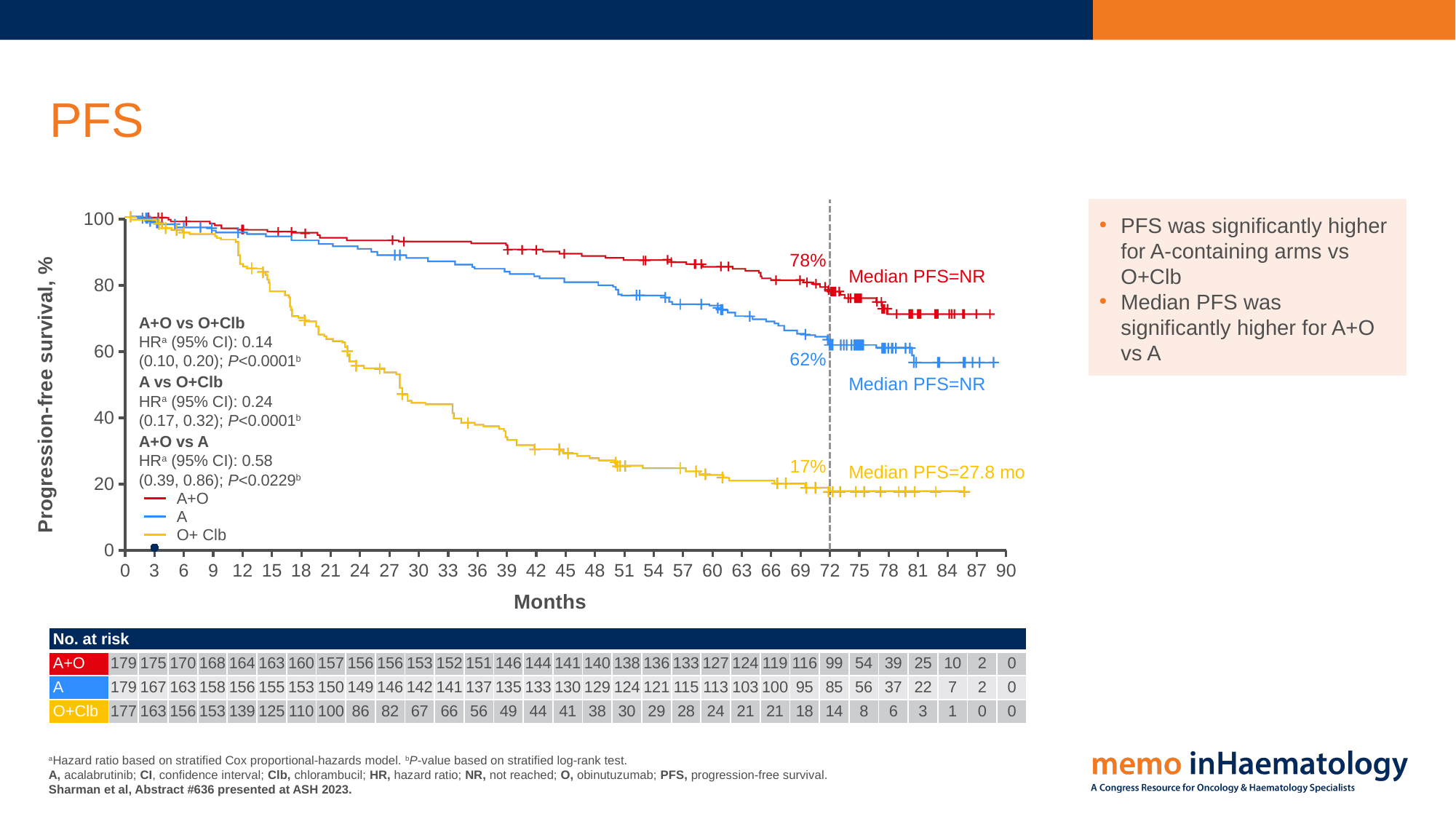
Do the progression-free survival curves rise or fall as months increase? Fall Which arm has the lowest progression-free survival at 72 months? O+Clb At 72 months, which arm has higher progression-free survival, A or O+Clb? A What is the progression-free survival for the O+Clb arm at 72 months? 17% What kind of chart is shown? Line chart (Kaplan-Meier curve) How many treatment arms does the legend list? 3 What is the difference in progression-free survival at 72 months between the A+O arm and the A arm? 16 percentage points Which arm has the highest progression-free survival at 72 months? A+O What is the median PFS for the O+Clb arm? 27.8 mo What is the progression-free survival for the A arm at 72 months? 62% What is the progression-free survival for the A+O arm at 72 months? 78% Is the progression-free survival for the A+O arm at 36 months greater or less than 80? greater